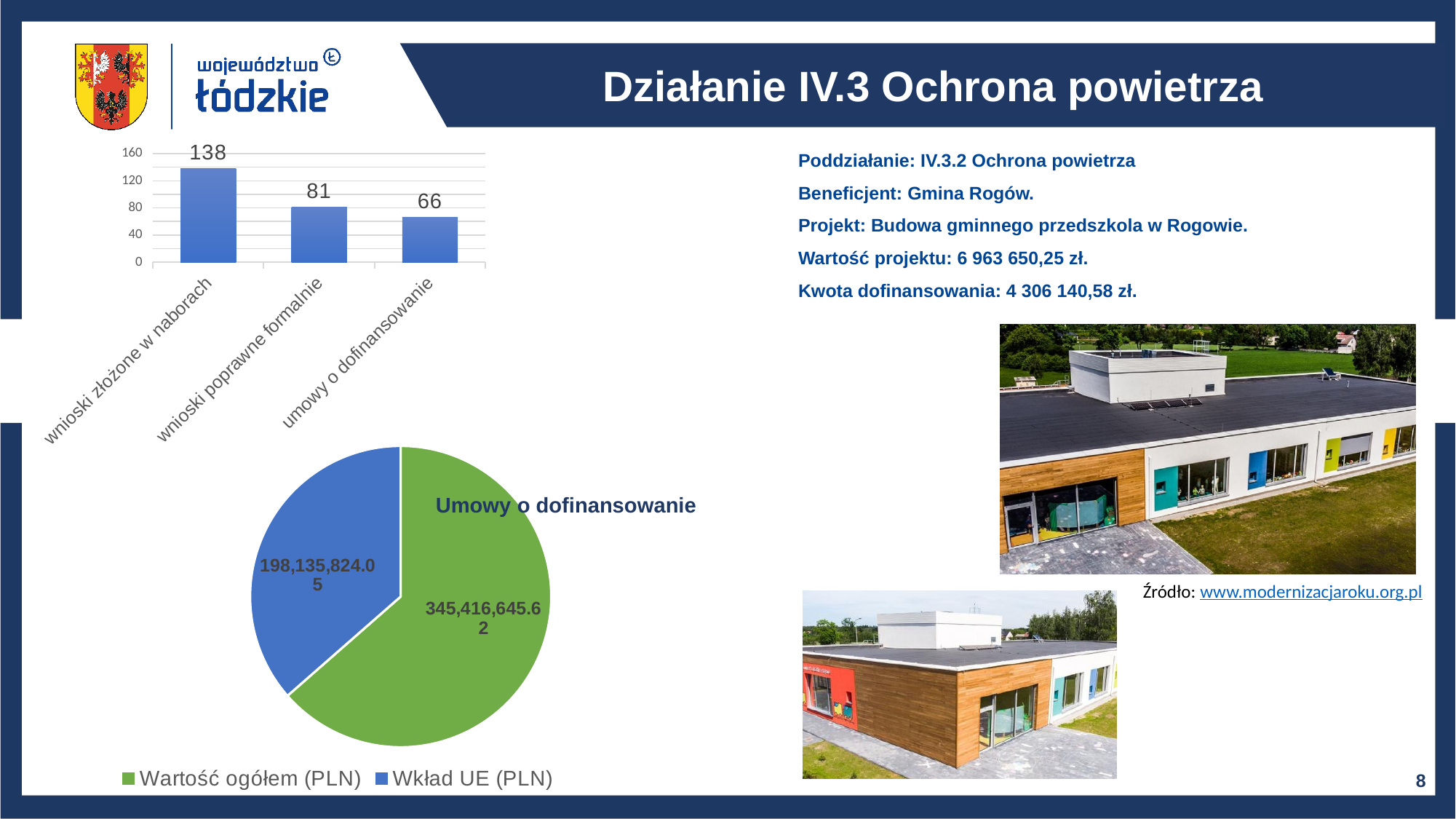
In the bar chart at the top left, what is the difference between 'wnioski złożone w naborach' and 'wnioski poprawne formalnie'? 57 In the bar chart at the top left, do the values rise or fall from left to right? fall In the bar chart at the top left, how many categories are shown? 3 In the pie chart 'Umowy o dofinansowanie', which is larger: 'Wartość ogółem (PLN)' or 'Wkład UE (PLN)'? Wartość ogółem (PLN) In the bar chart at the top left, what is the difference between 'wnioski poprawne formalnie' and 'umowy o dofinansowanie'? 15 In the bar chart at the top left, which category has the lowest value? umowy o dofinansowanie In the pie chart 'Umowy o dofinansowanie', what is the value for 'Wartość ogółem (PLN)'? 345,416,645.62 In the bar chart at the top left, what is the value for 'wnioski złożone w naborach'? 138 In the bar chart at the top left, what is the value for 'wnioski poprawne formalnie'? 81 In the bar chart at the top left, which category has the highest value? wnioski złożone w naborach In the bar chart at the top left, what is the value for 'umowy o dofinansowanie'? 66 In the pie chart 'Umowy o dofinansowanie', what is the value for 'Wkład UE (PLN)'? 198,135,824.05